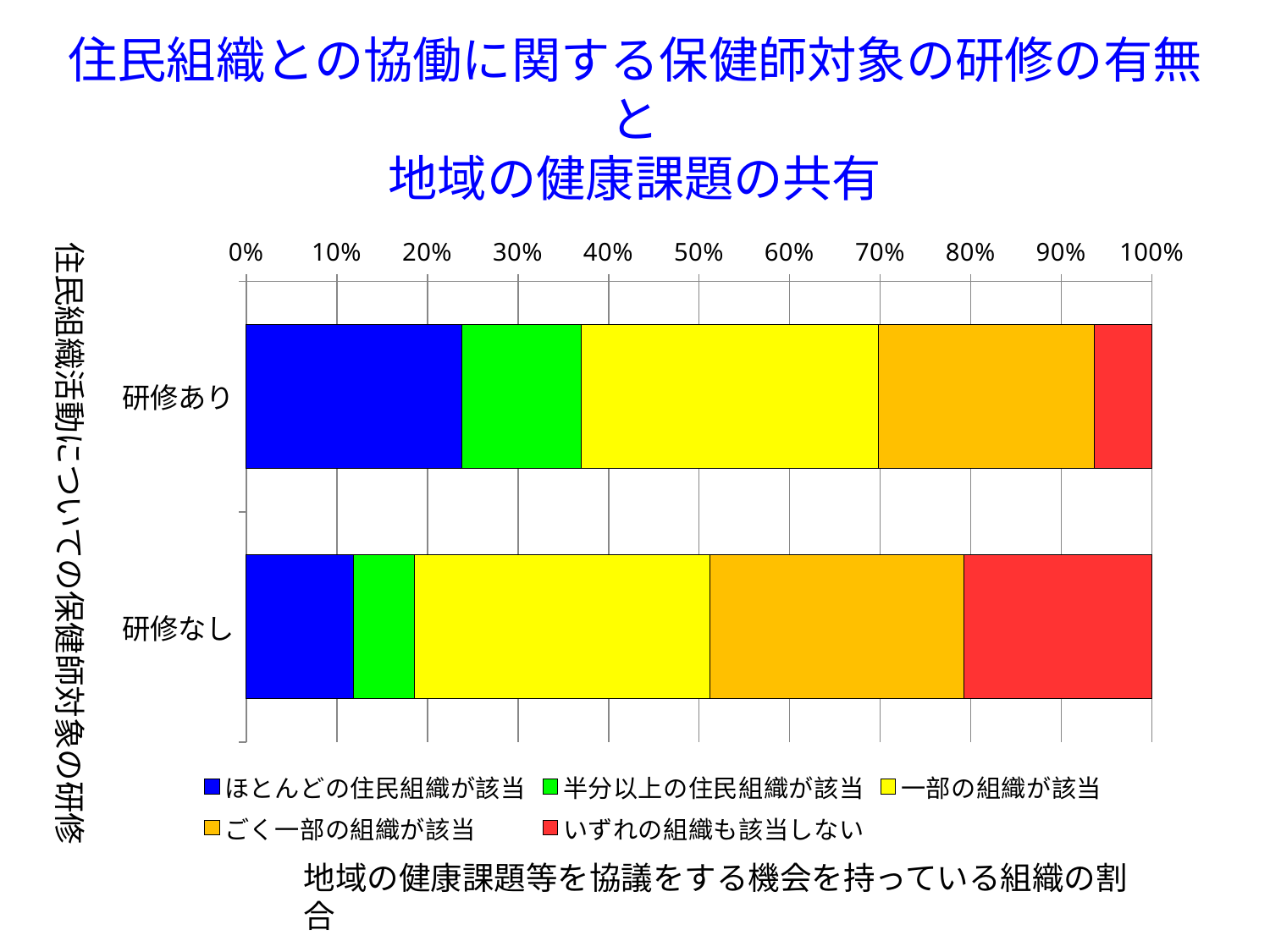
Within the 研修あり bar, which series has the smallest segment? いずれの組織も該当しない Is the value of ほとんどの住民組織が該当 for 研修あり greater or less than 20%? greater Is the value of いずれの組織も該当しない for 研修なし greater or less than 10%? greater How many categories (bars) are plotted on the chart? 2 What kind of chart is shown on the slide? Stacked bar chart Which category has the larger share of ほとんどの住民組織が該当, 研修あり or 研修なし? 研修あり Is the value of いずれの組織も該当しない for 研修あり greater or less than 10%? less Which category has the larger share of いずれの組織も該当しない, 研修あり or 研修なし? 研修なし How many series does the legend list? 5 Within the 研修あり bar, which series has the largest segment? 一部の組織が該当 What colour represents いずれの組織も該当しない in the legend? Red